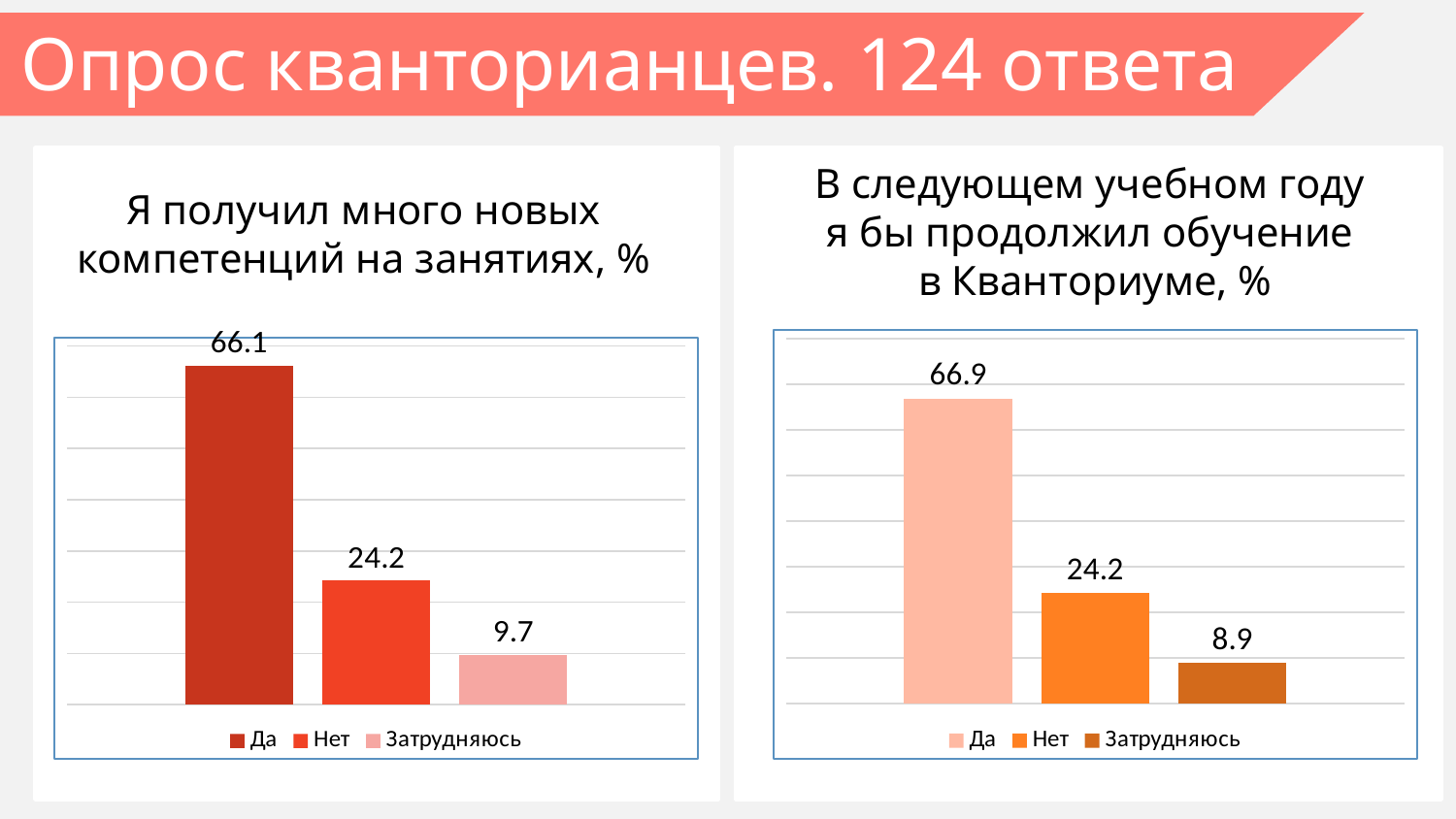
How many categories are shown in the right chart? 3 In the right chart, what is the difference between the values for "Нет" and "Затрудняюсь"? 15.3 In the left chart ("Я получил много новых компетенций на занятиях, %"), what is the value for "Да"? 66.1 In the right chart ("В следующем учебном году я бы продолжил обучение в Кванториуме, %"), what is the value for "Затрудняюсь"? 8.9 In the left chart, which category has the highest value? Да In the right chart ("В следующем учебном году я бы продолжил обучение в Кванториуме, %"), what is the value for "Да"? 66.9 Which is larger: the value for "Да" in the left chart or the value for "Да" in the right chart? Да in the right chart In the left chart ("Я получил много новых компетенций на занятиях, %"), what is the value for "Затрудняюсь"? 9.7 What kind of chart is the left chart? Bar chart In the left chart, what is the difference between the values for "Да" and "Нет"? 41.9 In the right chart, which category has the lowest value? Затрудняюсь In the left chart ("Я получил много новых компетенций на занятиях, %"), what is the value for "Нет"? 24.2